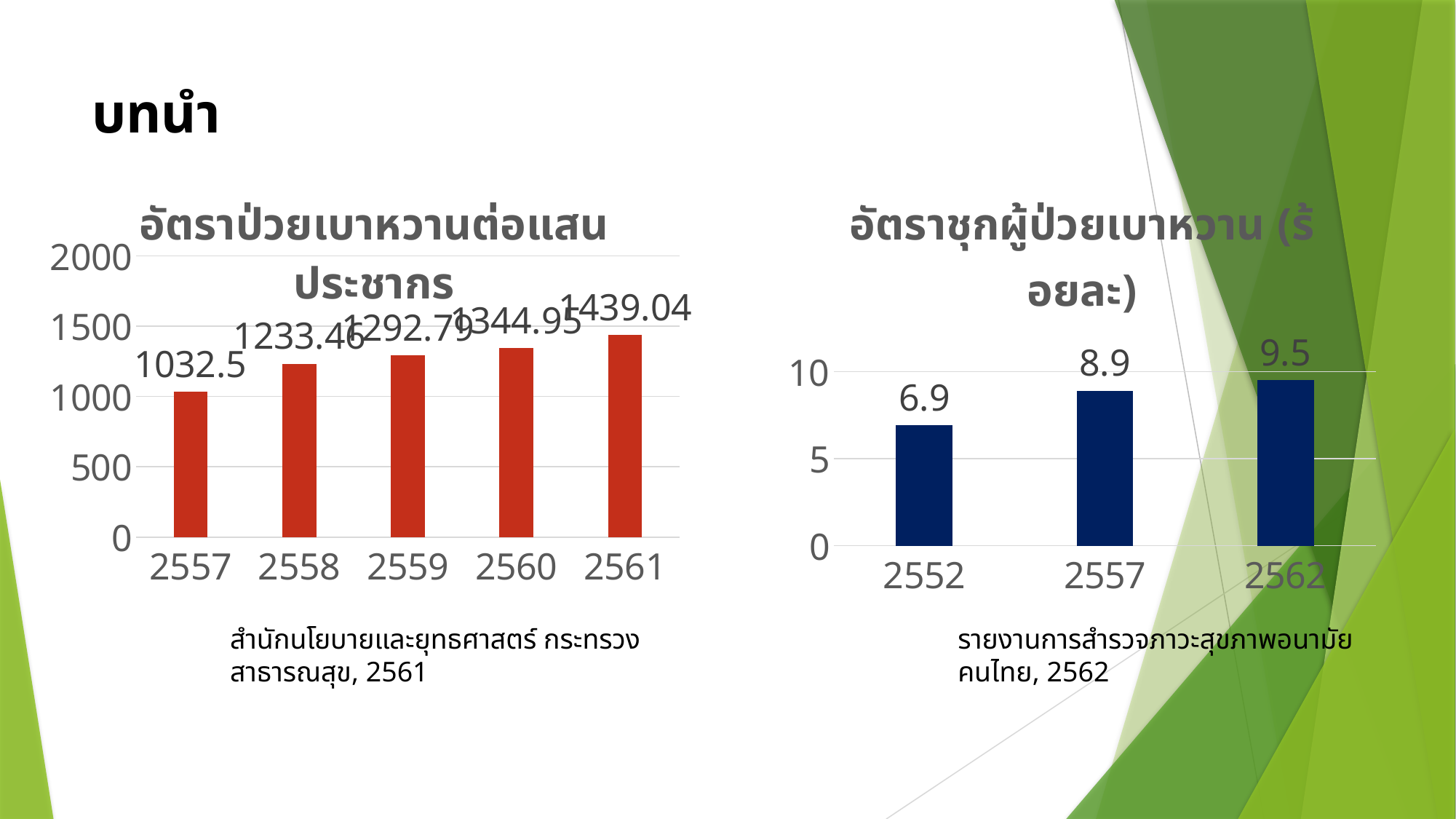
How many years are shown in the left chart (อัตราป่วยเบาหวานต่อแสนประชากร)? 5 In the right chart (อัตราชุกผู้ป่วยเบาหวาน (ร้อยละ)), what is the value for 2562? 9.5 In the left chart (อัตราป่วยเบาหวานต่อแสนประชากร), what is the difference between the values for 2561 and 2557? 406.54 In the left chart (อัตราป่วยเบาหวานต่อแสนประชากร), which year has the lowest value? 2557 What type of chart is the right chart (อัตราชุกผู้ป่วยเบาหวาน (ร้อยละ))? bar chart In the left chart (อัตราป่วยเบาหวานต่อแสนประชากร), do the values rise or fall from 2557 to 2561? rise In the right chart (อัตราชุกผู้ป่วยเบาหวาน (ร้อยละ)), what is the difference between the values for 2562 and 2552? 2.6 In the left chart (อัตราป่วยเบาหวานต่อแสนประชากร), what is the value for 2560? 1344.95 In the left chart (อัตราป่วยเบาหวานต่อแสนประชากร), which year has the highest value? 2561 In the left chart (อัตราป่วยเบาหวานต่อแสนประชากร), what is the value for 2561? 1439.04 In the left chart (อัตราป่วยเบาหวานต่อแสนประชากร), what is the value for 2557? 1032.5 In the right chart (อัตราชุกผู้ป่วยเบาหวาน (ร้อยละ)), what is the value for 2552? 6.9